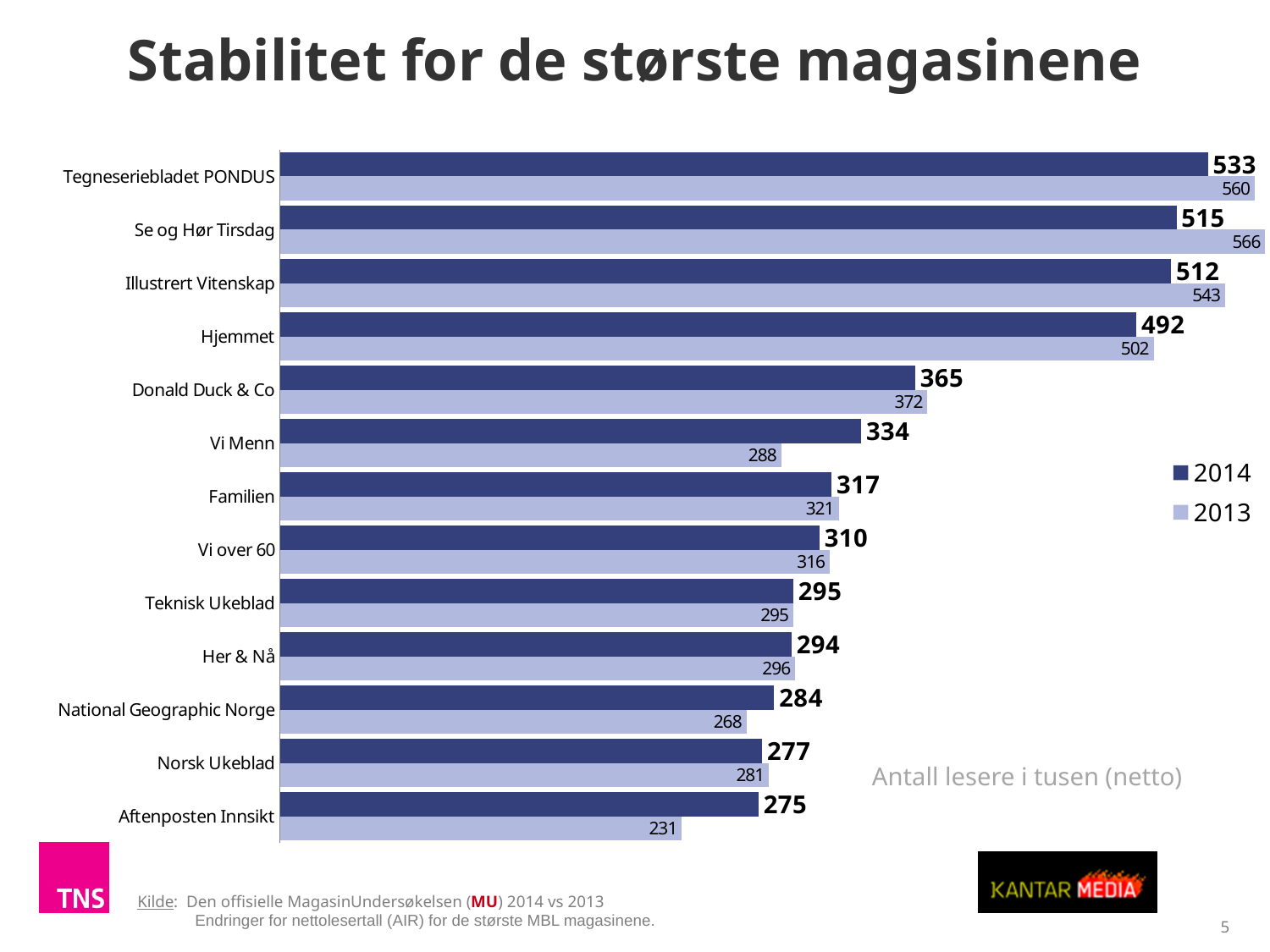
How many series does the legend list? 2 What is the 2013 value for Se og Hør Tirsdag? 566 What is the 2013 value for Vi Menn? 288 Which magazine has the highest 2014 value? Tegneseriebladet PONDUS What is the 2014 value for Aftenposten Innsikt? 275 What is the difference between the 2013 and 2014 values for Vi Menn? 46 What kind of chart is shown on the slide? Bar chart How many magazines are shown in the chart? 13 Which is larger for Hjemmet, the 2014 value or the 2013 value? 2013 What is the 2014 value for Tegneseriebladet PONDUS? 533 Which magazine has the lowest 2013 value? Aftenposten Innsikt What is the title of the slide? Stabilitet for de største magasinene